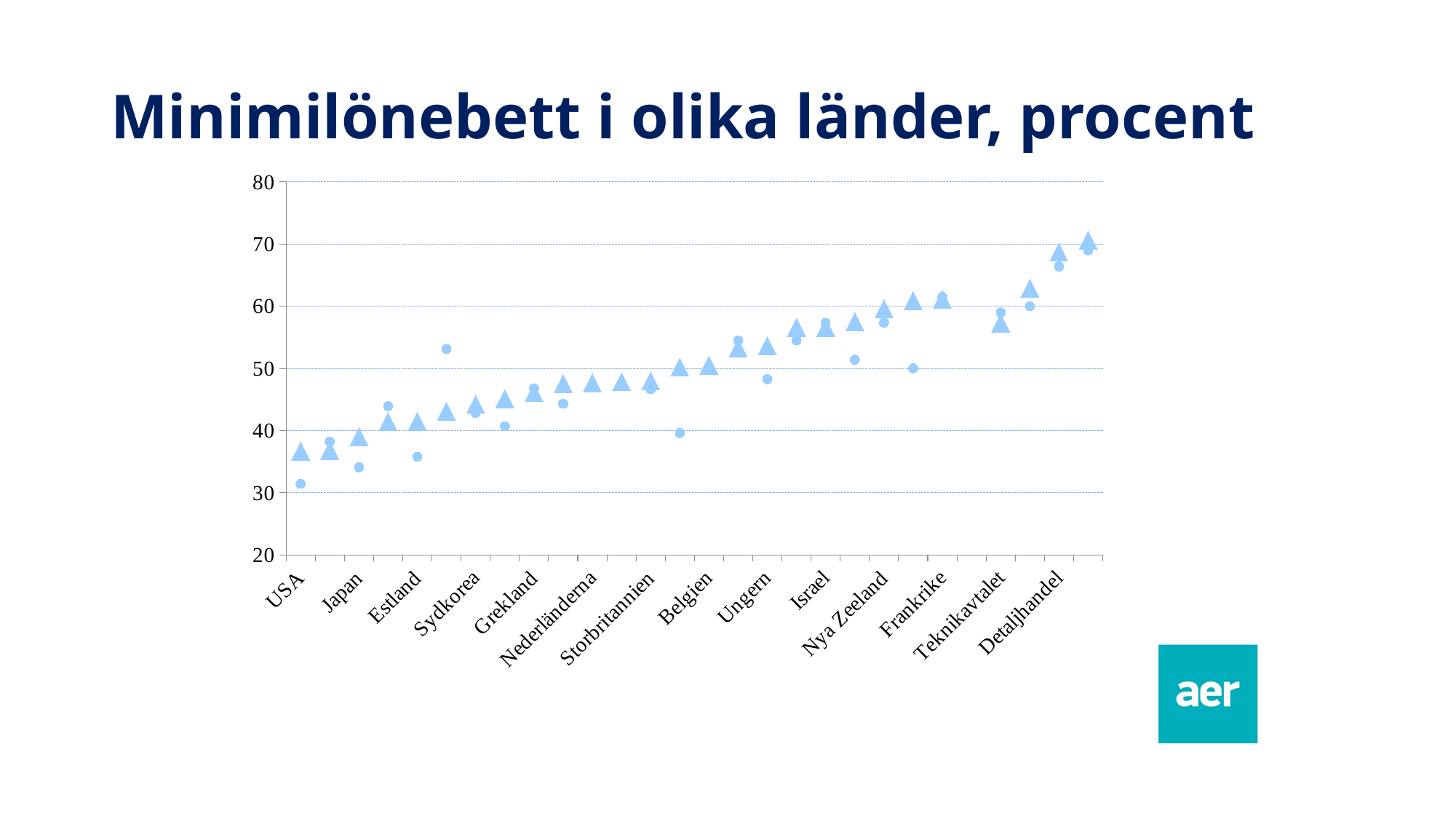
What is the title of the chart? Minimilönebett i olika länder, procent Is the circle marker value for Israel greater or less than 60? less What kind of chart is shown on the slide? scatter chart Do the triangle markers generally rise or fall from left to right along the x axis? rise Is the circle marker value for Grekland greater or less than 50? less Is the circle marker value for USA greater or less than 40? less